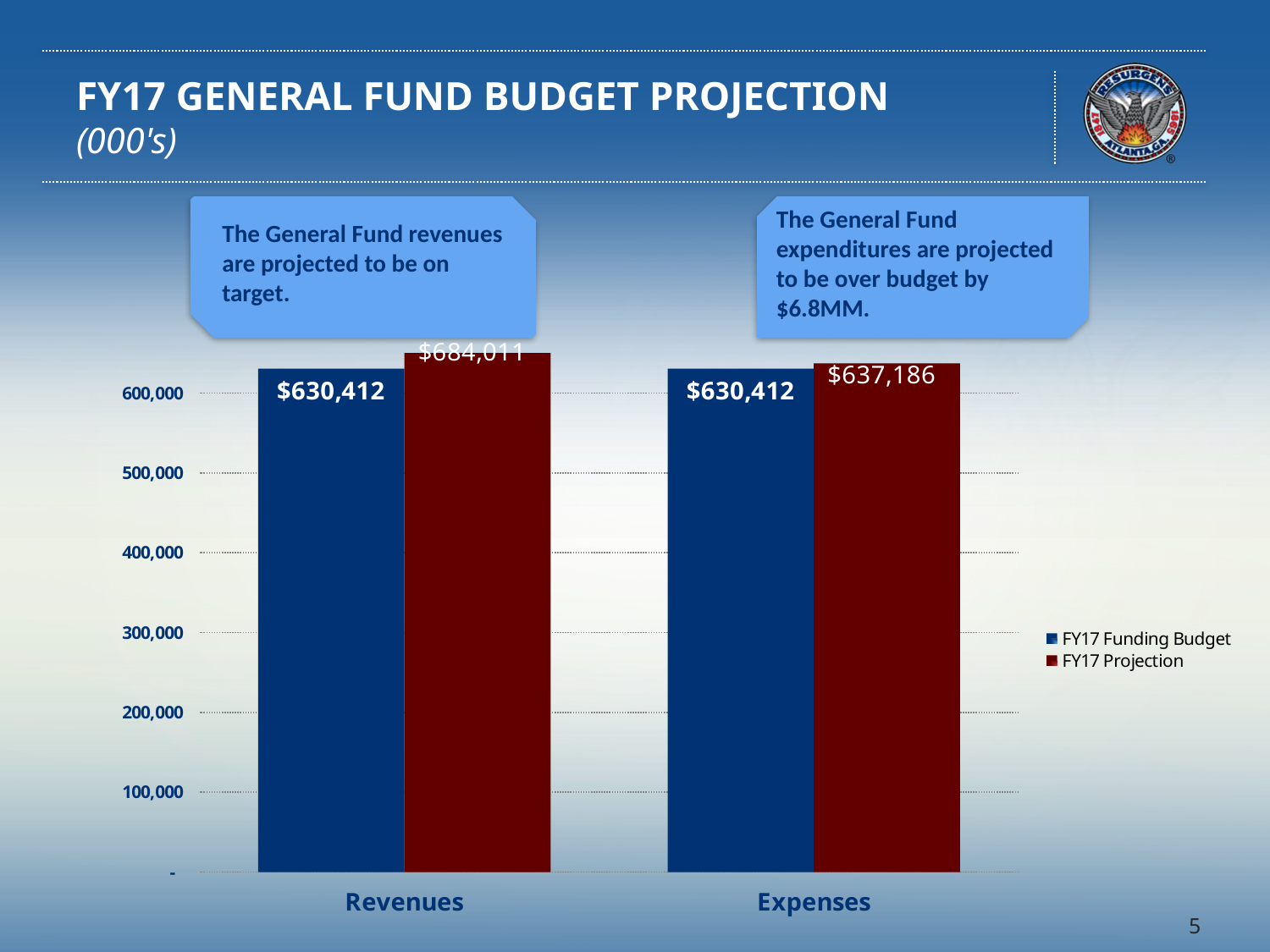
What is the difference between the FY17 Projection and the FY17 Funding Budget for Revenues? $53,599 Which category has the highest FY17 Projection value? Revenues What is the difference between the FY17 Projection and the FY17 Funding Budget for Expenses? $6,774 What is the FY17 Projection value for Expenses? $637,186 How many categories are shown on the x axis? 2 What is the FY17 Projection value for Revenues? $684,011 What is the FY17 Funding Budget value for Expenses? $630,412 Which series is shown in dark red? FY17 Projection Which is larger, the FY17 Projection for Revenues or the FY17 Projection for Expenses? FY17 Projection for Revenues How many series does the legend list? 2 What kind of chart is shown on the slide? Bar chart What is the FY17 Funding Budget value for Revenues? $630,412